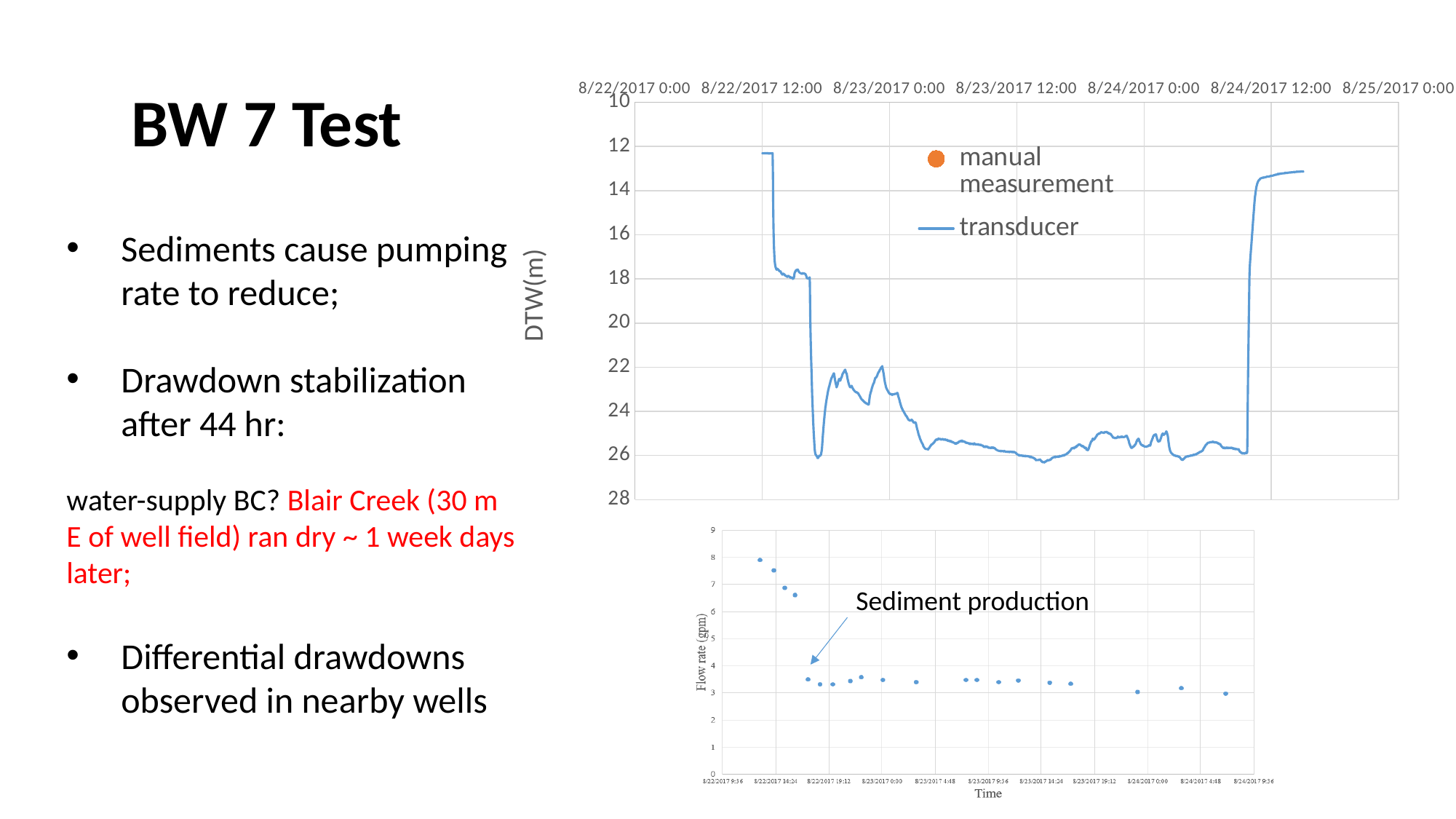
In the top chart, what is the label on the vertical axis? DTW(m) In the top chart, how many series does the legend list? 2 In the bottom chart, is the first flow rate point greater or less than 7 gpm? greater In the top chart, is the final transducer value near 8/25/2017 0:00 greater or less than 16? less In the top chart, is the transducer value at 8/24/2017 0:00 greater or less than 24? greater What kind of chart is the bottom chart with the Flow rate (gpm) axis? scatter chart In the top chart, what are the two legend entries? manual measurement, transducer In the bottom chart, does the flow rate generally rise or fall over time? fall What kind of chart is the top chart with the DTW(m) axis? line chart